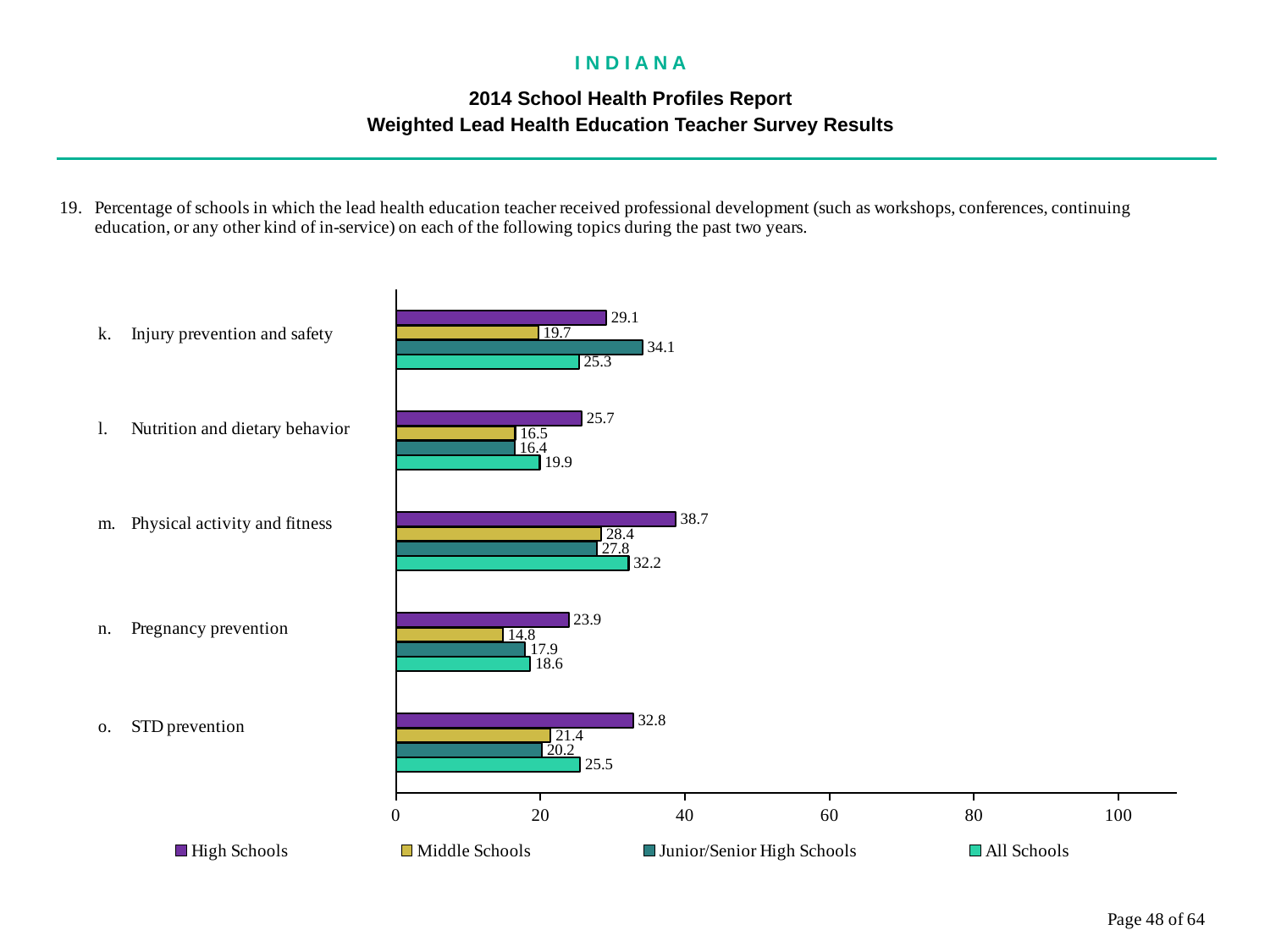
Which is larger for Nutrition and dietary behavior: the Middle Schools value or the All Schools value? All Schools What kind of chart is shown on the slide? Bar chart Which topic has the lowest value for Middle Schools? Pregnancy prevention What is the difference between the High Schools and Middle Schools values for STD prevention? 11.4 What is the value for Middle Schools on Pregnancy prevention? 14.8 How many topics are shown on the chart? 5 What is the value for All Schools on STD prevention? 25.5 What is the value for Junior/Senior High Schools on Injury prevention and safety? 34.1 Which topic has the highest value for High Schools? Physical activity and fitness How many series does the legend list? 4 What is the value for High Schools on Physical activity and fitness? 38.7 Which series is shown in purple in the legend? High Schools